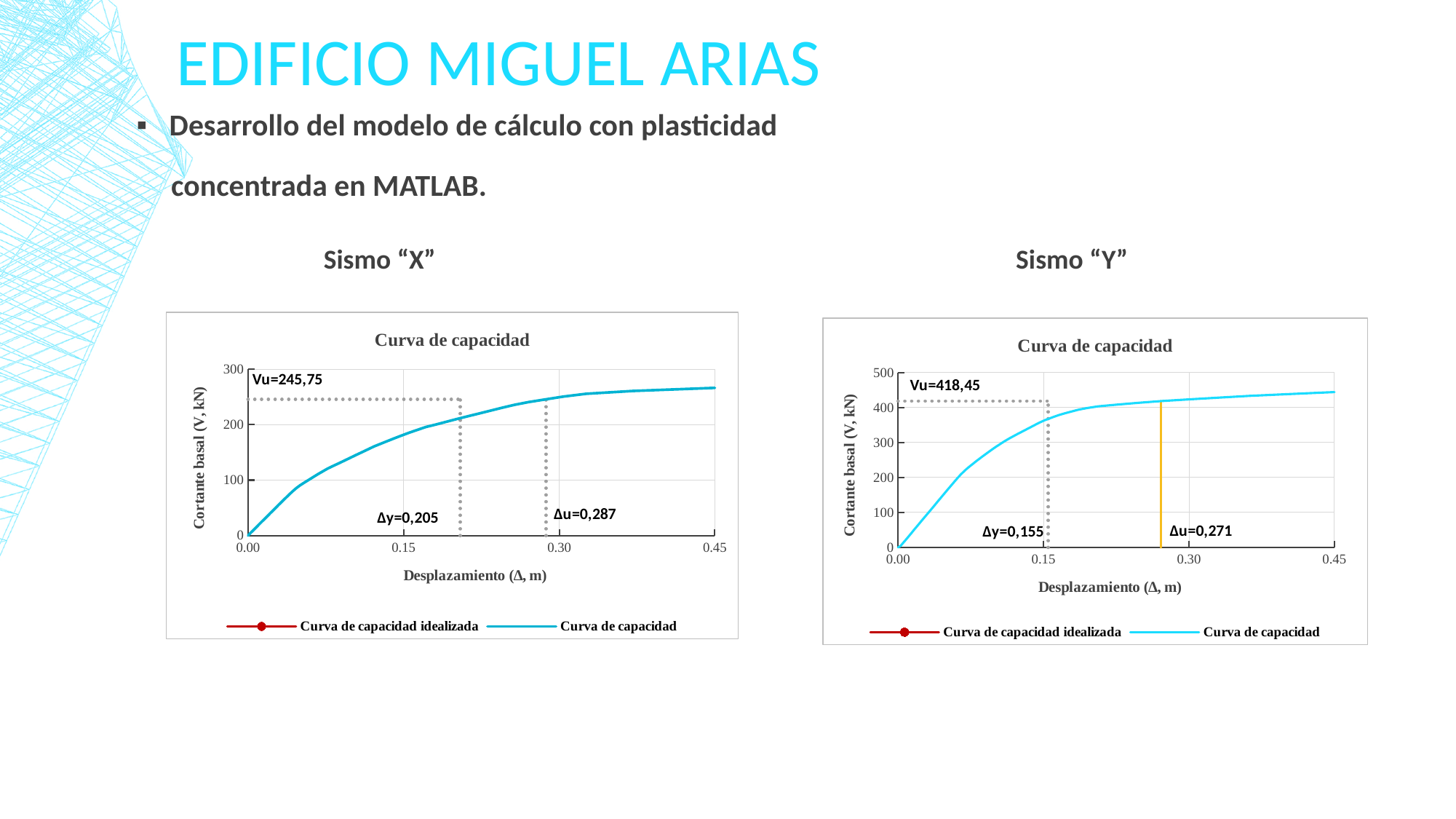
In the Sismo "X" chart, what is the value of Vu shown on the chart? 245,75 What is the difference between the Vu value in the Sismo "Y" chart and the Vu value in the Sismo "X" chart? 172,70 In the Sismo "X" chart, does the Curva de capacidad rise or fall as displacement increases along the x axis? Rise In the Sismo "X" chart, what is the value of Δy? 0,205 In the Sismo "Y" chart, what is the value of Δy? 0,155 Which chart shows the larger Vu value, Sismo "X" or Sismo "Y"? Sismo "Y" In the Sismo "Y" chart, what is the value of Vu shown on the chart? 418,45 In the Sismo "Y" chart, is the Curva de capacidad value at a displacement of 0.15 greater or less than 300? greater In the Sismo "X" chart, what is the value of Δu? 0,287 In the Sismo "Y" chart, what is the value of Δu? 0,271 How many series does the legend of the Sismo "Y" chart list? 2 What kind of chart is the Sismo "X" Curva de capacidad chart? Line chart